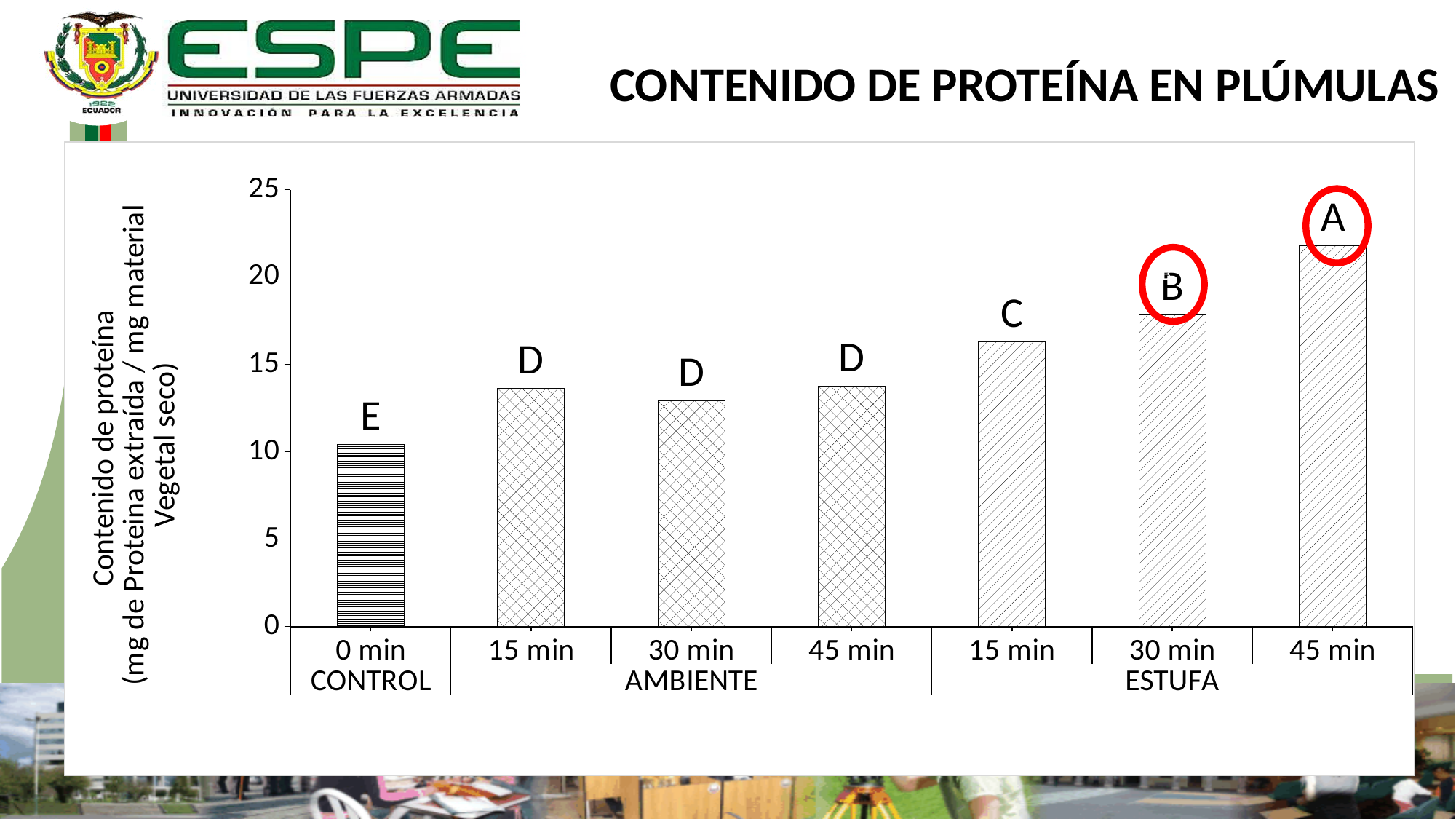
Is the value for 15 min ESTUFA greater or less than 15? greater What letter is printed above the 45 min ESTUFA bar? A What is the title of the slide's chart? CONTENIDO DE PROTEÍNA EN PLÚMULAS Is the value for 45 min ESTUFA greater or less than 20? greater Within the ESTUFA group, do the values rise or fall from 15 min to 45 min? rise How many bars are plotted in the chart? 7 What kind of chart is shown on the slide? bar chart Is the value for 30 min ESTUFA greater or less than 20? less Which bar has the lowest protein content? 0 min CONTROL Which bar has the highest protein content? 45 min ESTUFA Which is larger, the value for 15 min ESTUFA or the value for 45 min AMBIENTE? 15 min ESTUFA